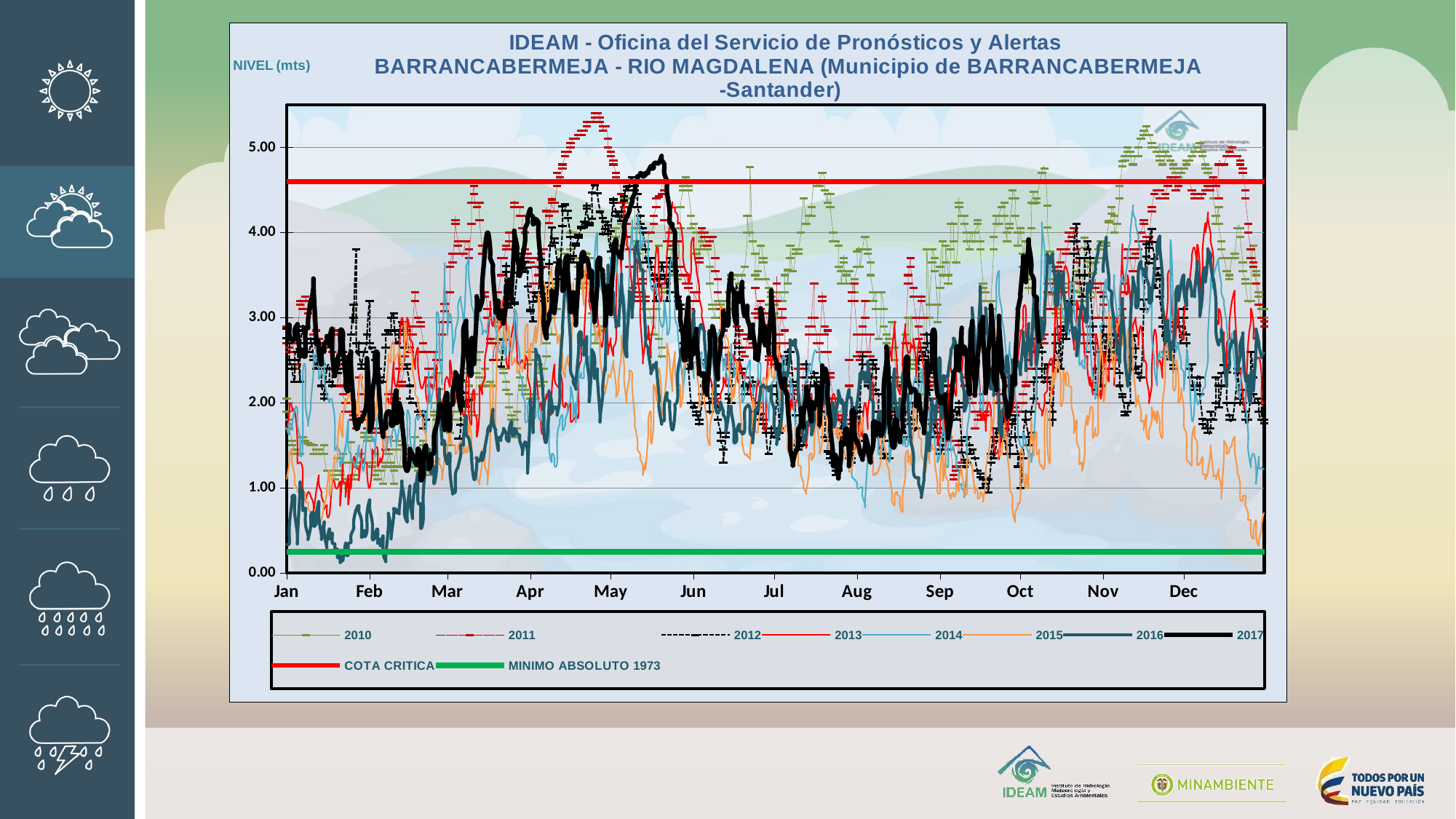
Which is larger: the COTA CRITICA line or the MINIMO ABSOLUTO 1973 line? COTA CRITICA Is the COTA CRITICA reference line greater or less than 4.00? greater What colour is the 2017 series drawn in on the chart? black How many entries does the chart legend list? 10 How many months are labelled along the x axis of the chart? 12 Which year's series reaches the highest peak on the chart? 2011 Is the highest peak of the 2011 series greater or less than 5.00? greater Is the MINIMO ABSOLUTO 1973 reference line greater or less than 1.00? less What kind of chart is shown on the slide? line chart What is the label of the y axis of the chart? NIVEL (mts)